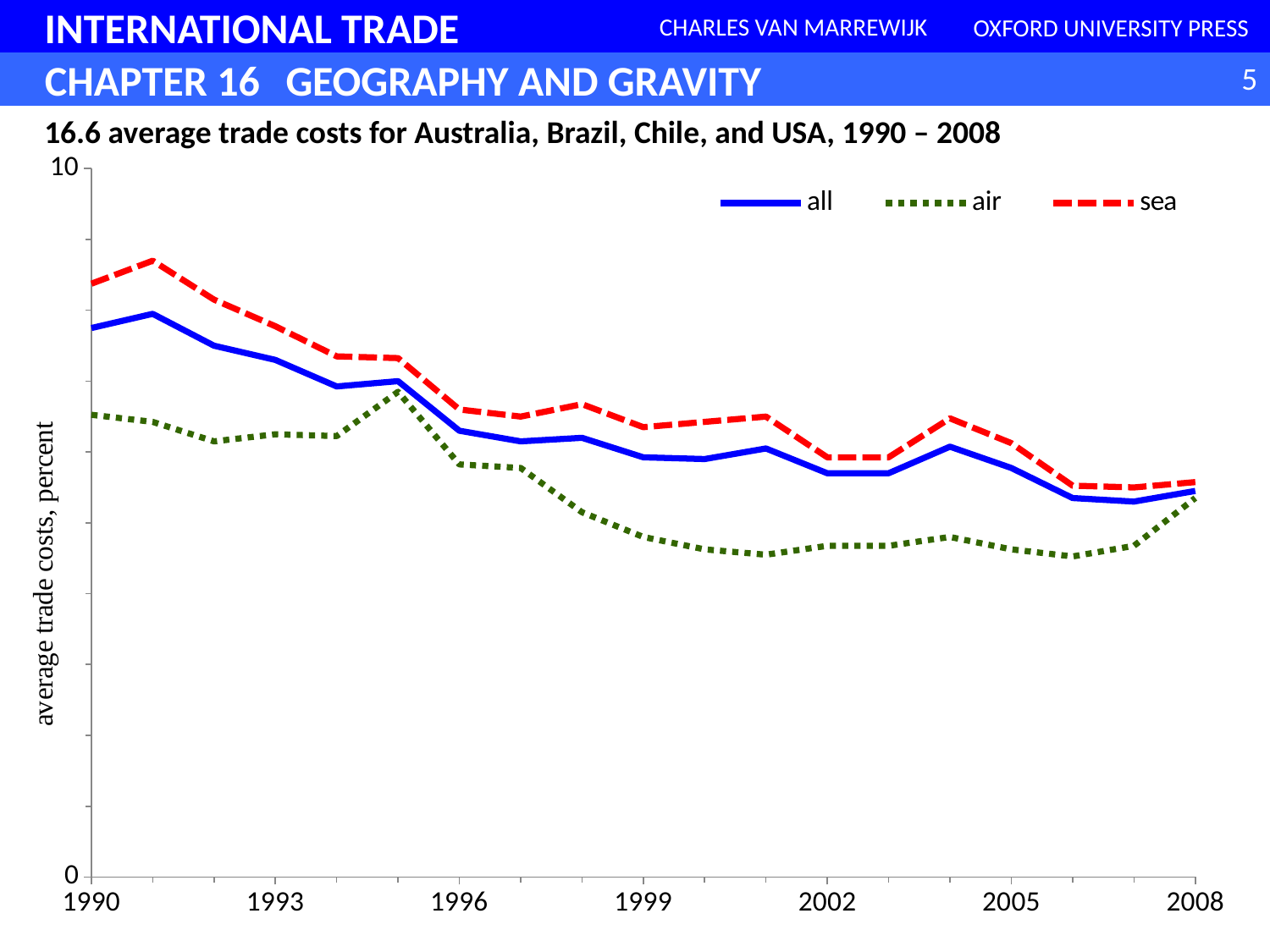
In which year does the sea series reach its highest value? 1991 What is the first year and the last year shown on the x axis? 1990 and 2008 What is the label on the vertical axis? average trade costs, percent Do the average trade costs for the 'all' series rise or fall from 1990 to 2008 overall? fall Is the value for sea in 1990 greater or less than 10? less Which series are listed in the legend? all, air, sea Which series has the highest value in 1990? sea In which year does the air series reach its highest value? 1995 Which series has the lowest value in 2000? air How many series does the legend list? 3 In 1990, which is larger: the value for sea or the value for air? sea What kind of chart is shown on the slide? line chart